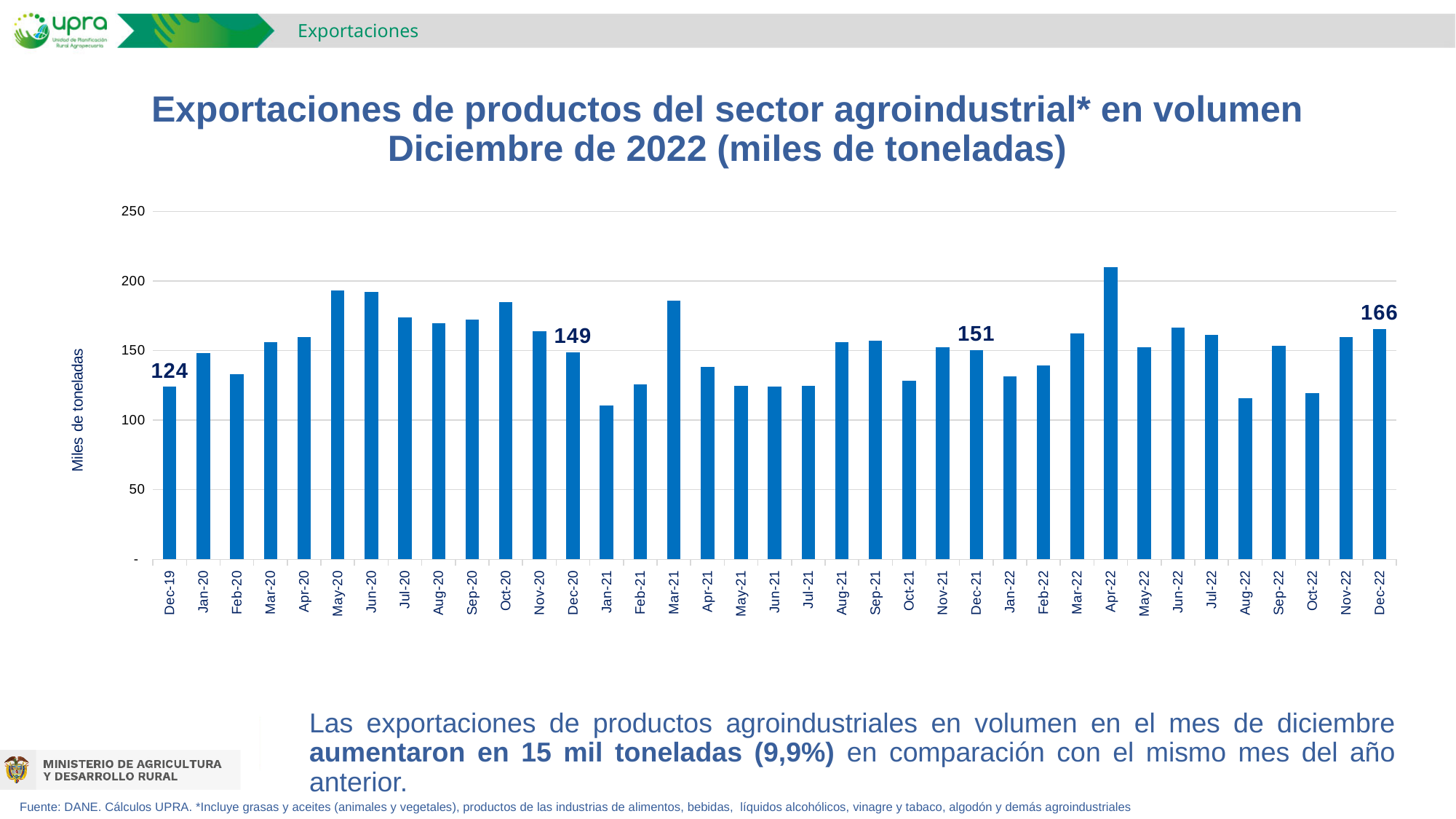
What is the value for Dec-22? 166 What is the difference between the values for Dec-20 and Dec-19? 25 What is the value for Dec-20? 149 Is the value for Jan-21 greater or less than 150? less How many months (bars) are shown in the chart? 37 Which is larger, the value for Dec-22 or the value for Dec-19? Dec-22 What is the value for Dec-21? 151 What is the difference between the values for Dec-22 and Dec-21? 15 Is the value for Apr-22 greater or less than 200? greater What is the value for Dec-19? 124 Which month has the highest value in the chart? Apr-22 What kind of chart is shown on the slide? Bar chart